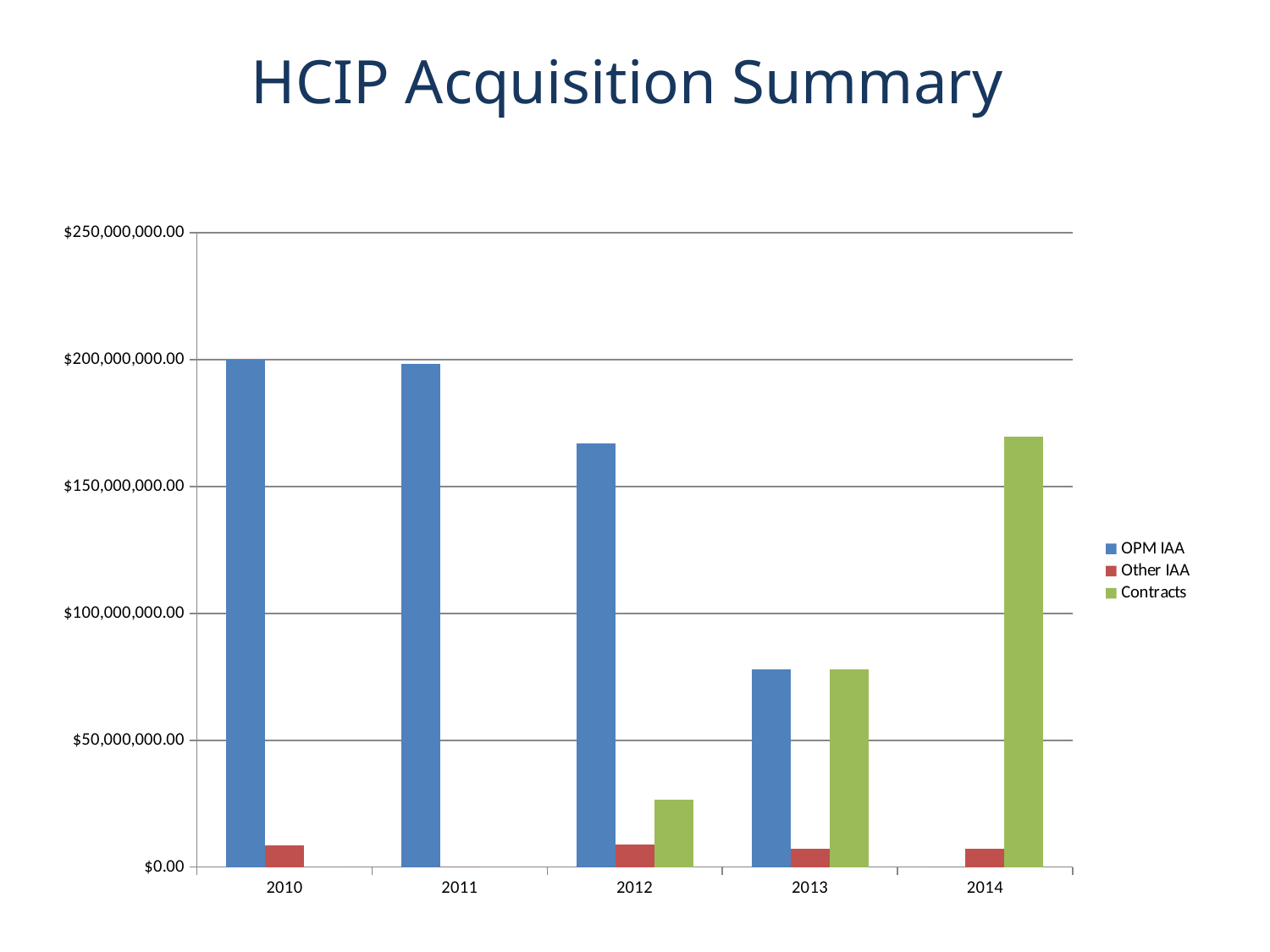
How many years are shown on the x axis? 5 Which is larger, the Contracts value for 2013 or the Contracts value for 2014? 2014 Is the OPM IAA value for 2012 greater or less than $150,000,000.00? greater Which year has the highest Contracts value? 2014 Do the OPM IAA values rise or fall from 2010 to 2013? Fall Is the OPM IAA value for 2013 greater or less than $100,000,000.00? less In 2012, which is larger, OPM IAA or Contracts? OPM IAA Which year has the lowest Contracts value among the years where Contracts is plotted? 2012 Is the Contracts value for 2012 greater or less than $50,000,000.00? less How many series does the legend list? 3 What is the title of the chart? HCIP Acquisition Summary What kind of chart is shown on the slide? Bar chart